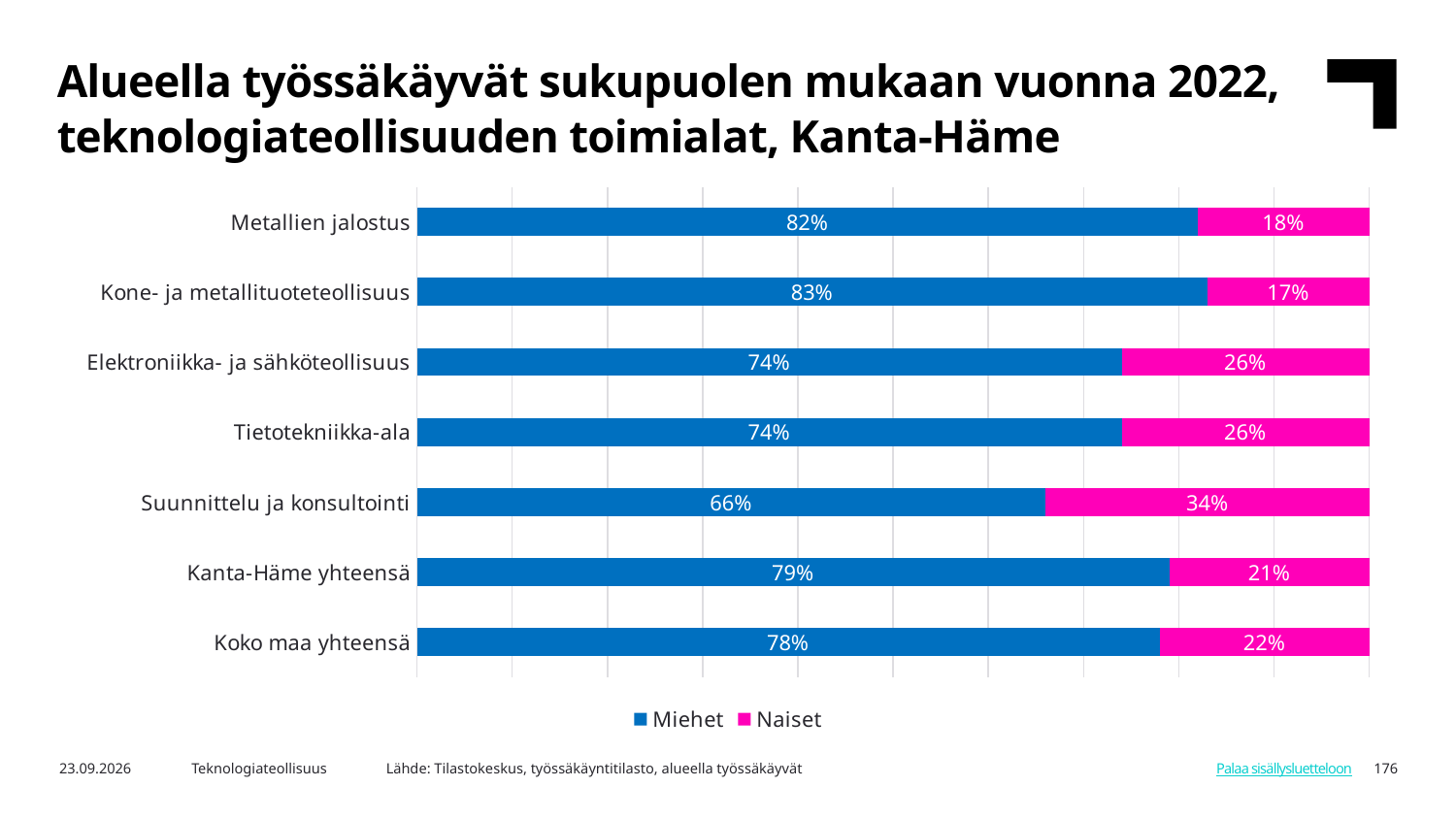
Which is larger: the Naiset share for Metallien jalostus or for Tietotekniikka-ala? Tietotekniikka-ala What is the total of the stacked bar for Elektroniikka- ja sähköteollisuus? 100% What is the difference between the Miehet share for Kanta-Häme yhteensä and Koko maa yhteensä? 1 percentage point What is the Miehet share for Metallien jalostus? 82% What is the Naiset share for Kone- ja metallituoteteollisuus? 17% What is the Naiset share for Suunnittelu ja konsultointi? 34% What is the Miehet share for Koko maa yhteensä? 78% How many categories are shown on the chart? 7 How many series does the legend list? 2 What kind of chart is shown on the slide? Stacked bar chart Which category has the highest Naiset share? Suunnittelu ja konsultointi Which category has the lowest Miehet share? Suunnittelu ja konsultointi